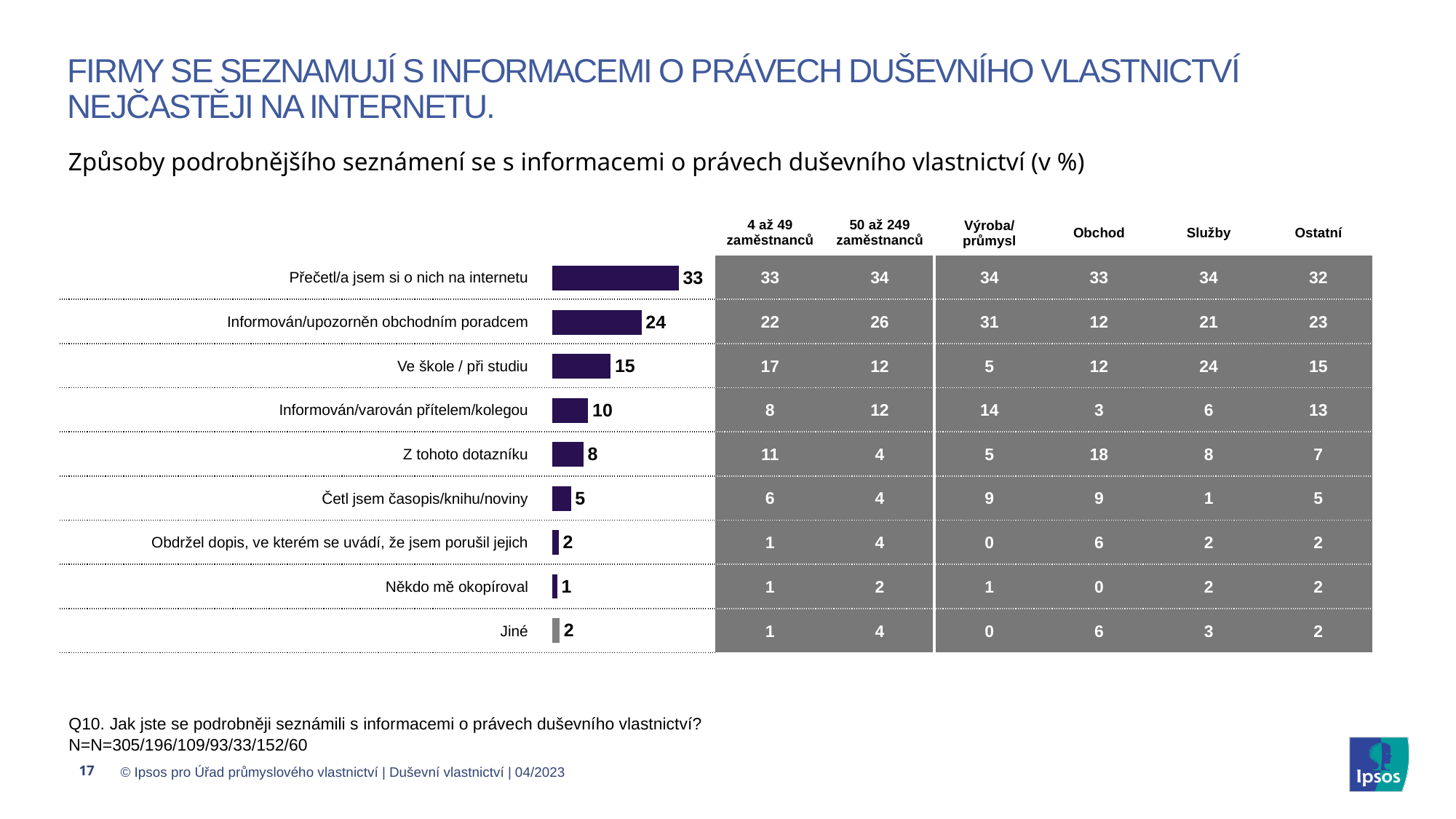
What value is shown for "Ve škole / při studiu" in the bar chart? 15 What value is shown for "Jiné" in the bar chart? 2 Which has a larger value in the bar chart: "Ve škole / při studiu" or "Informován/varován přítelem/kolegou"? Ve škole / při studiu How many categories are shown in the bar chart? 9 What value is shown for "Z tohoto dotazníku" in the bar chart? 8 What kind of chart is shown on the slide? Bar chart What is the difference between the values for "Přečetl/a jsem si o nich na internetu" and "Informován/upozorněn obchodním poradcem" in the bar chart? 9 What is the difference between the values for "Informován/varován přítelem/kolegou" and "Četl jsem časopis/knihu/noviny" in the bar chart? 5 What value is shown for "Přečetl/a jsem si o nich na internetu" in the bar chart? 33 Which category has the highest value in the bar chart? Přečetl/a jsem si o nich na internetu Which bar in the chart is drawn in a different (grey) colour from the others? Jiné Which category has the lowest value in the bar chart? Někdo mě okopíroval